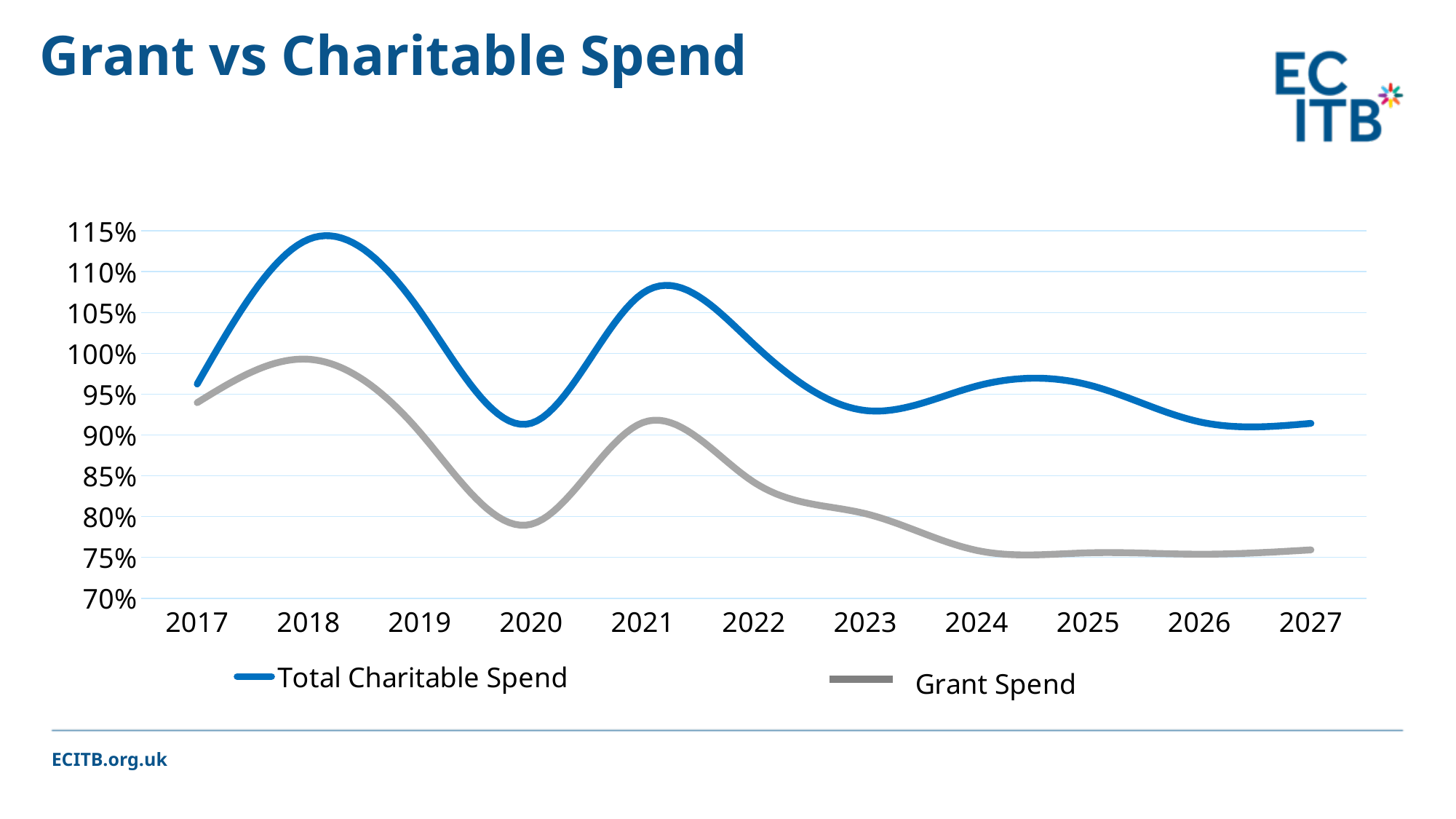
How many series does the legend list? 2 Is the value for Grant Spend in 2020 greater or less than 85%? less How many years are shown along the x axis? 11 In which year is Total Charitable Spend highest? 2018 Is the value for Grant Spend in 2024 greater or less than 80%? less Is the value for Total Charitable Spend in 2018 greater or less than 110%? greater Which is larger in 2020, Total Charitable Spend or Grant Spend? Total Charitable Spend What kind of chart is shown on the slide? Line chart In which year is Grant Spend highest? 2018 What is the title of the chart? Grant vs Charitable Spend Does Grant Spend rise or fall from 2021 to 2024? Fall